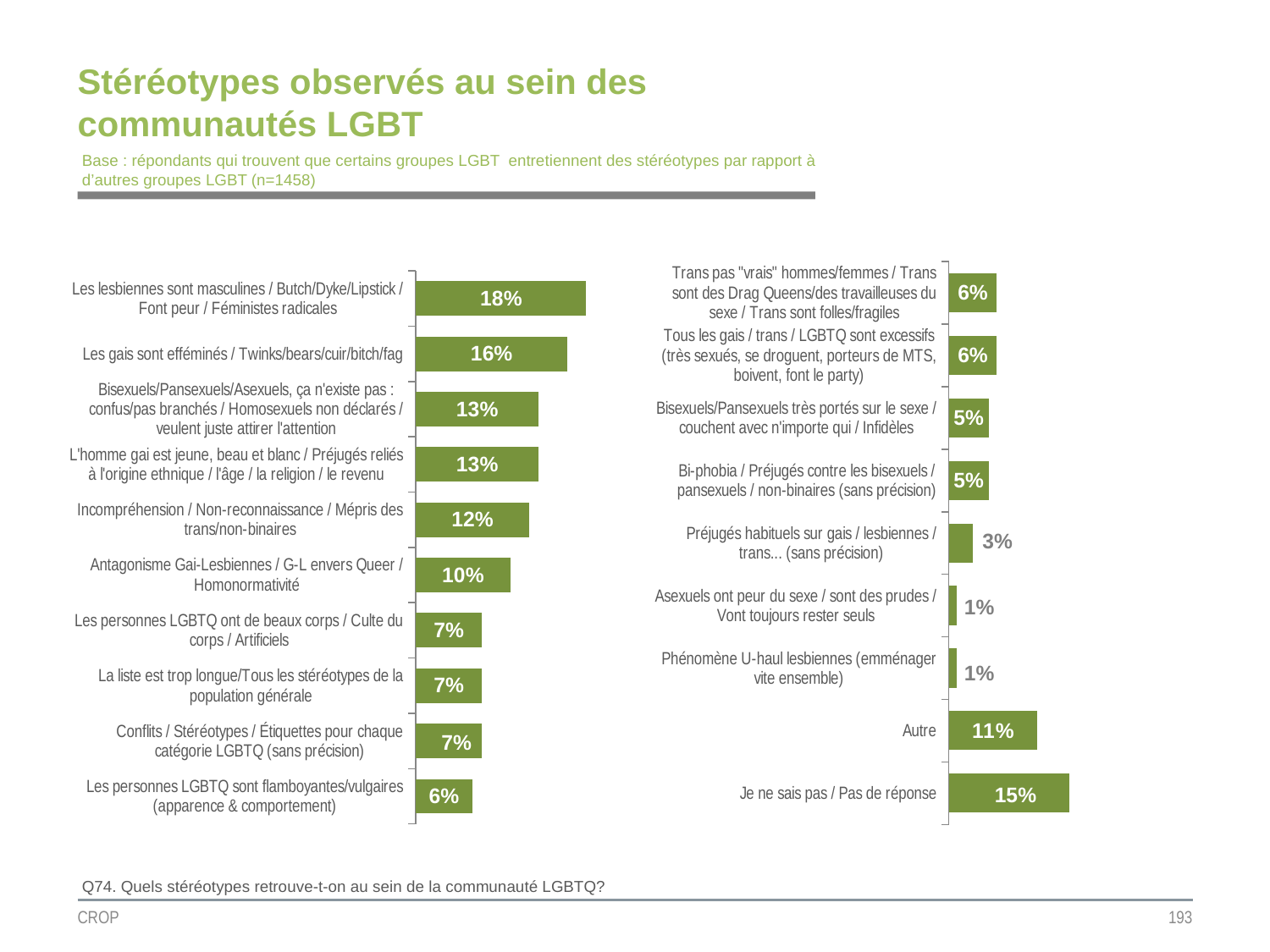
In the left chart, what is the value for "Les gais sont efféminés / Twinks/bears/cuir/bitch/fag"? 16% What type of chart is used on this slide? Bar chart In the right chart, which category has the highest value? Je ne sais pas / Pas de réponse In the left chart, what is the value for "Antagonisme Gai-Lesbiennes / G-L envers Queer / Homonormativité"? 10% In the right chart, what is the difference between the value for "Je ne sais pas / Pas de réponse" and the value for "Autre"? 4 percentage points In the left chart, what is the difference between the value for "Les lesbiennes sont masculines / Butch/Dyke/Lipstick / Font peur / Féministes radicales" and the value for "Incompréhension / Non-reconnaissance / Mépris des trans/non-binaires"? 6 percentage points How many categories are shown in the right chart? 9 In the right chart, what is the value for "Je ne sais pas / Pas de réponse"? 15% In the left chart, which category has the highest value? Les lesbiennes sont masculines / Butch/Dyke/Lipstick / Font peur / Féministes radicales In the right chart, what is the value for "Autre"? 11% How many categories are shown in the left chart? 10 In the right chart, which is larger: the value for "Autre" or the value for "Préjugés habituels sur gais / lesbiennes / trans… (sans précision)"? Autre